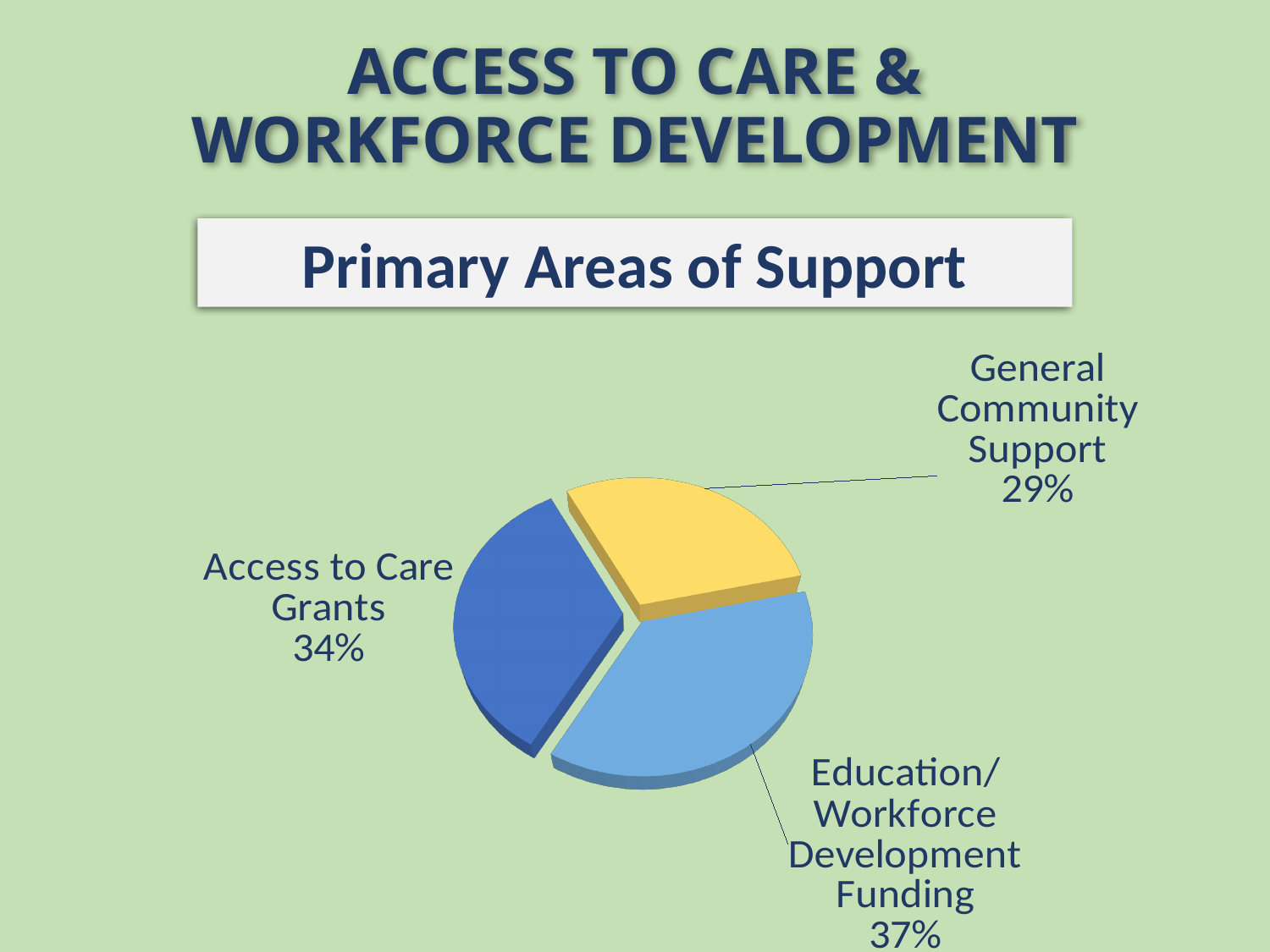
What is the difference in percentage points between Education/Workforce Development Funding and General Community Support? 8 Which is larger, Access to Care Grants or General Community Support? Access to Care Grants Which slice of the pie is the largest? Education/Workforce Development Funding Which slice of the pie is the smallest? General Community Support What colour is the General Community Support slice? yellow What share of the pie is Access to Care Grants? 34% What is the title shown above the pie chart? Primary Areas of Support How many slices does the pie chart have? 3 What kind of chart is shown on the slide? pie chart What share of the pie is Education/Workforce Development Funding? 37% What is the difference in percentage points between Access to Care Grants and General Community Support? 5 What share of the pie is General Community Support? 29%